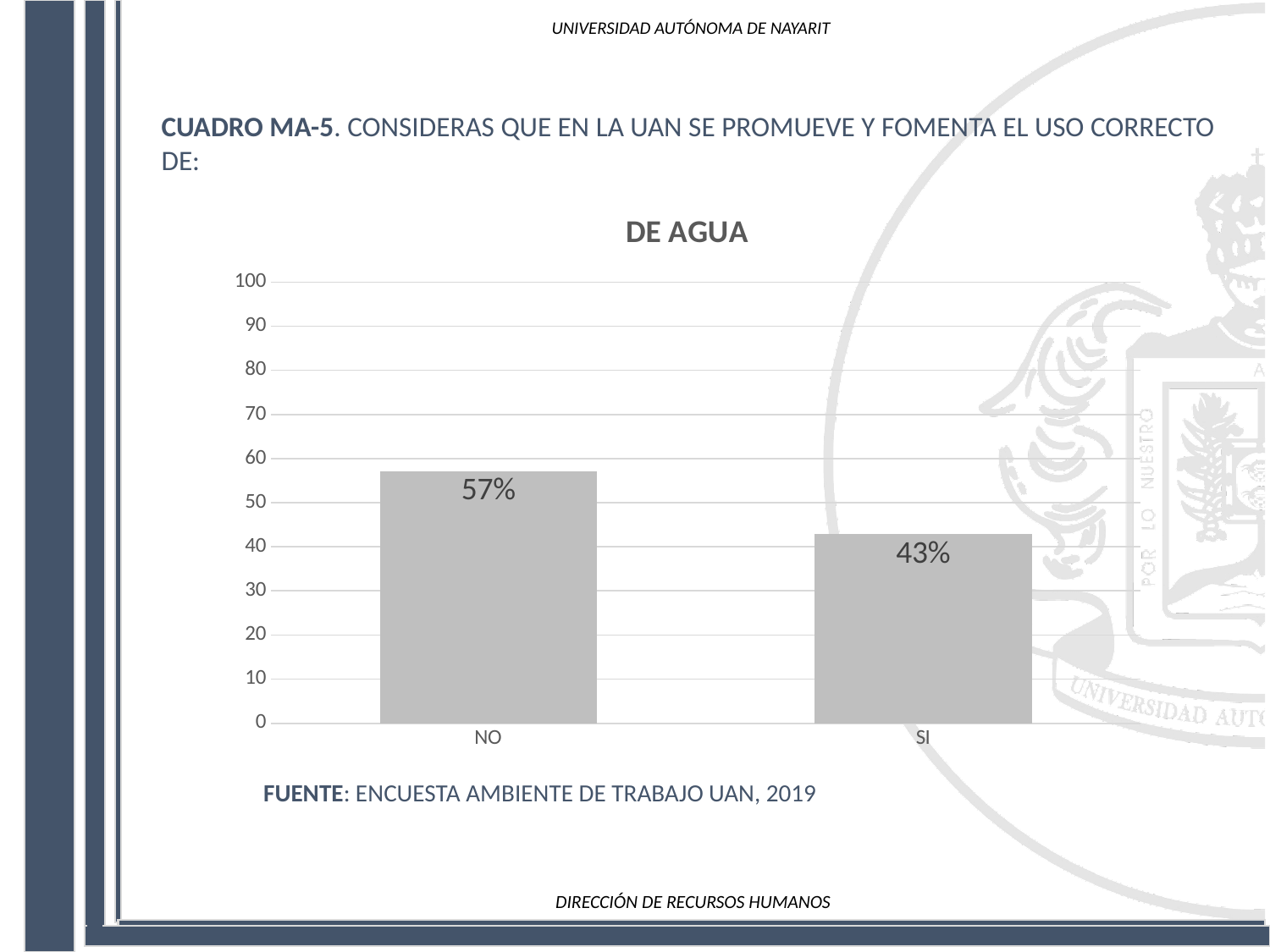
What is the title of the chart? DE AGUA What is the maximum value shown on the y axis? 100 How many categories are shown on the x axis? 2 Which category has the lowest value? SI What is the value for SI? 43% Is the value for NO greater or less than 50? greater What is the difference between the values for NO and SI? 14% What is the value for NO? 57% Is the value for SI greater or less than 50? less Which is larger, the value for NO or the value for SI? NO Which category has the highest value? NO What kind of chart is shown? bar chart